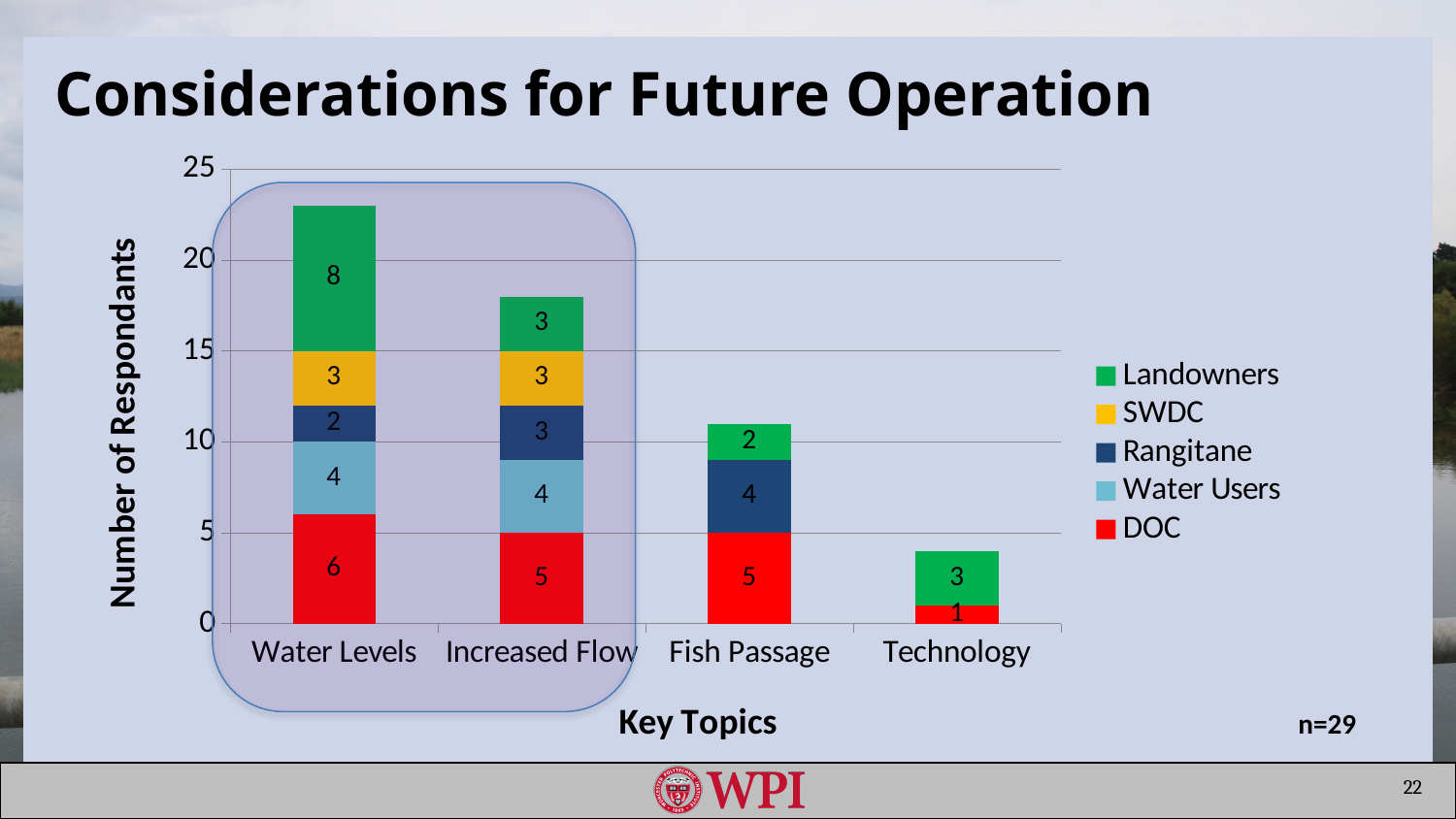
What is the total number of respondents for the Water Levels bar? 23 What is the total number of respondents for the Technology bar? 4 Is the total for the Fish Passage bar greater or less than 10? greater What is the Landowners value for Water Levels? 8 What is the DOC value for Increased Flow? 5 How many key topics (categories) are shown on the x axis? 4 How many series does the legend list? 5 What kind of chart is shown on the slide? stacked bar chart What is the difference between the Landowners values for Water Levels and Increased Flow? 5 What is the Rangitane value for Fish Passage? 4 Which key topic has the lowest total number of respondents? Technology Which key topic has the highest total number of respondents? Water Levels